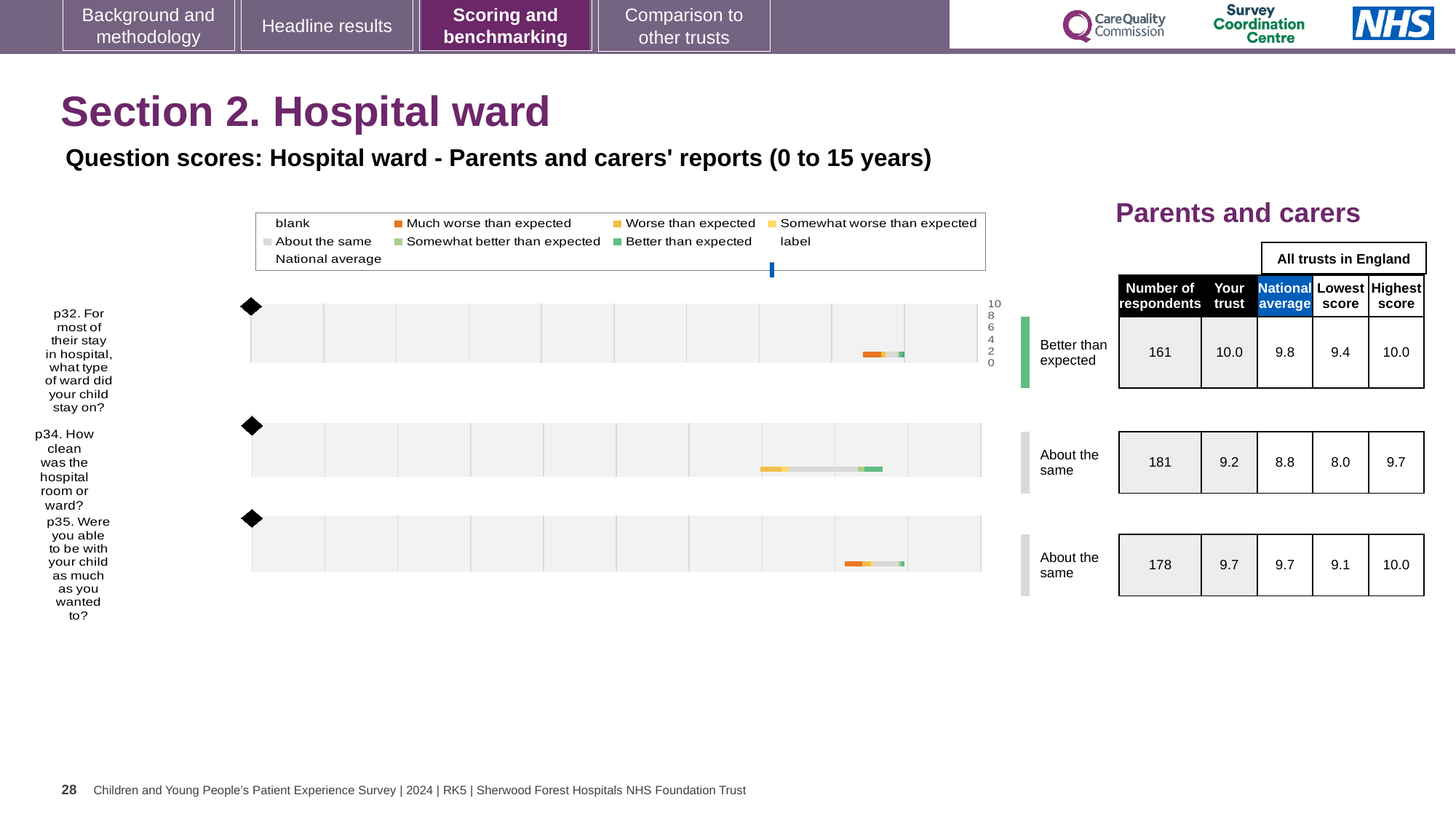
What is the 'Your trust' score for p34 (How clean was the hospital room or ward?)? 9.2 What colour represents 'Much worse than expected' in the legend? orange What kind of chart is used for each question on the slide? bar chart What is the national average score for p32 (what type of ward did your child stay on)? 9.8 Which question has the lowest 'Your trust' score? p34 Which question has the highest 'Your trust' score? p32 How many respondents answered p35 (Were you able to be with your child as much as you wanted to)? 178 What is the difference between the 'Your trust' score and the national average for p34? 0.4 Which benchmark category is p32 placed in? Better than expected How many survey questions are plotted on the slide? 3 What is the lowest score across all trusts in England for p34? 8.0 Which has the larger 'Your trust' score, p32 or p35? p32